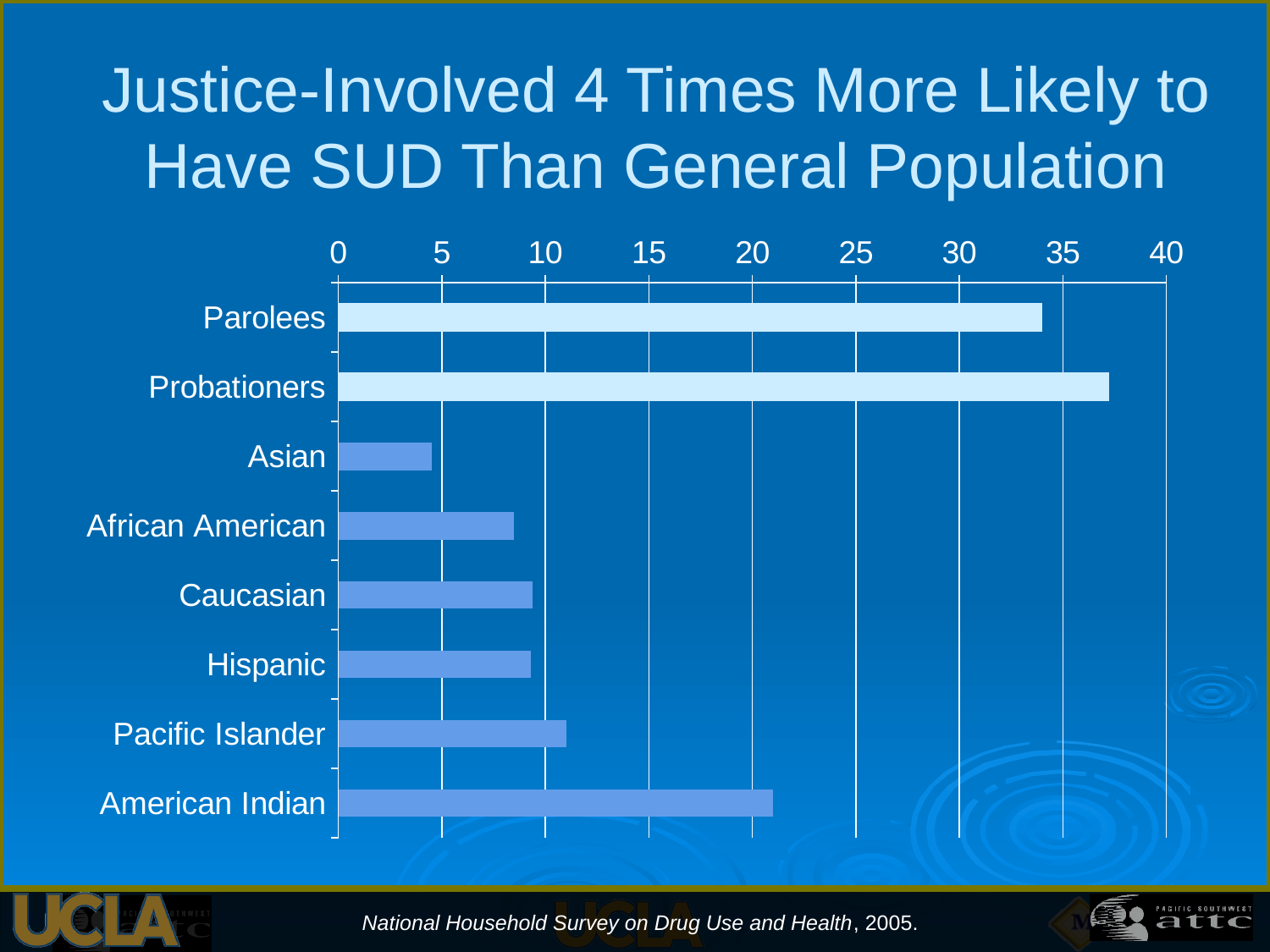
Is the value for African American greater or less than 10? less Is the value for Parolees greater or less than 35? less Is the value for American Indian greater or less than 20? greater Which is larger, the value for American Indian or the value for Pacific Islander? American Indian What kind of chart is shown on the slide? bar chart What is the title of the slide containing the chart? Justice-Involved 4 Times More Likely to Have SUD Than General Population Which category has the highest value in the chart? Probationers Which category has the lowest value in the chart? Asian How many categories are plotted in the chart? 8